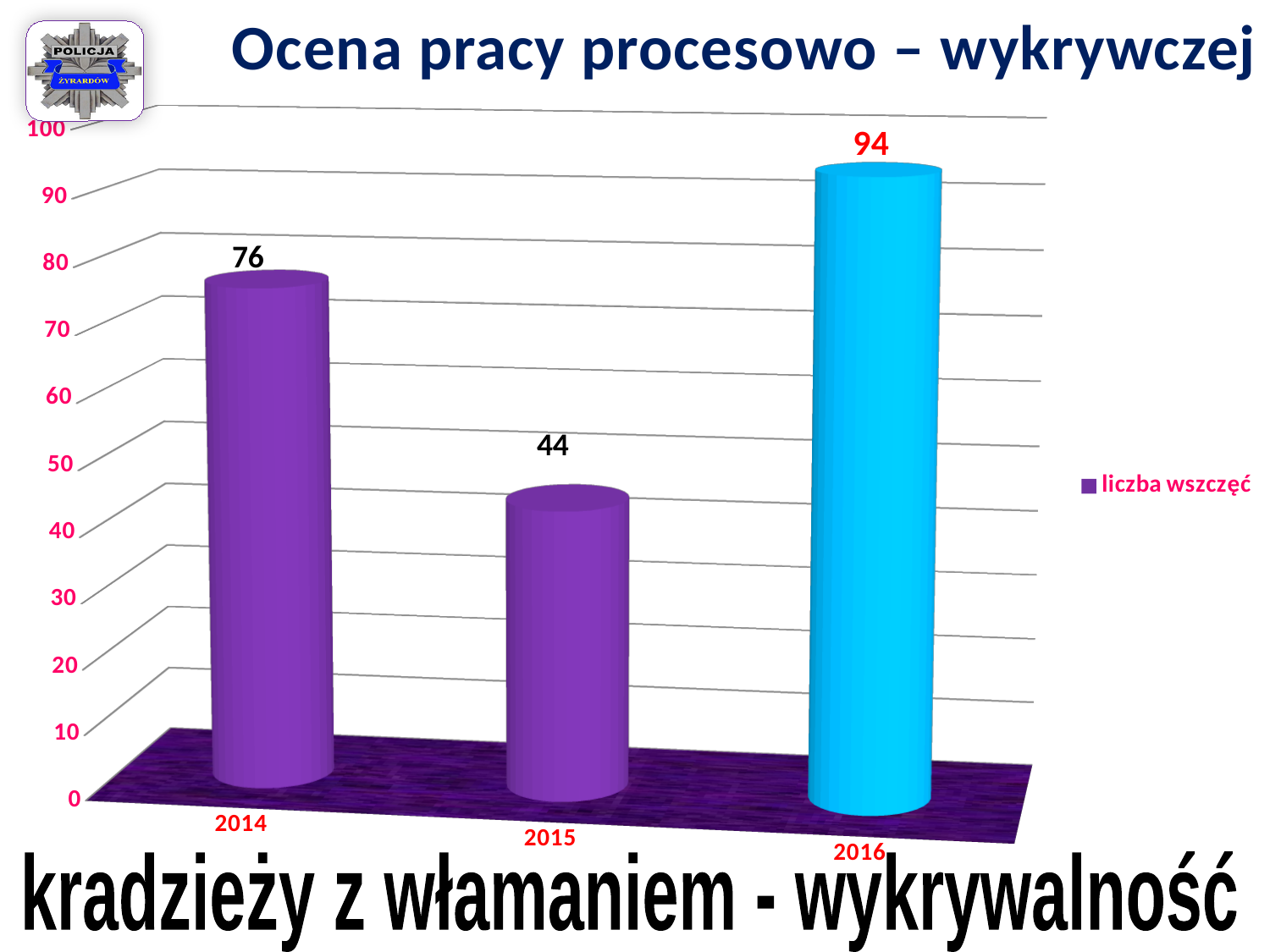
What is the difference between the values for 2014 and 2015? 32 What is the value for 2014? 76 What kind of chart is shown on the slide? bar chart What is the value for 2016? 94 Which is larger, the value for 2014 or the value for 2015? 2014 How many series does the legend list? 1 Which year has the lowest value? 2015 What is the legend entry shown on the chart? liczba wszczęć How many years are shown on the chart? 3 Which year has the highest value? 2016 What is the value for 2015? 44 What is the difference between the values for 2016 and 2014? 18